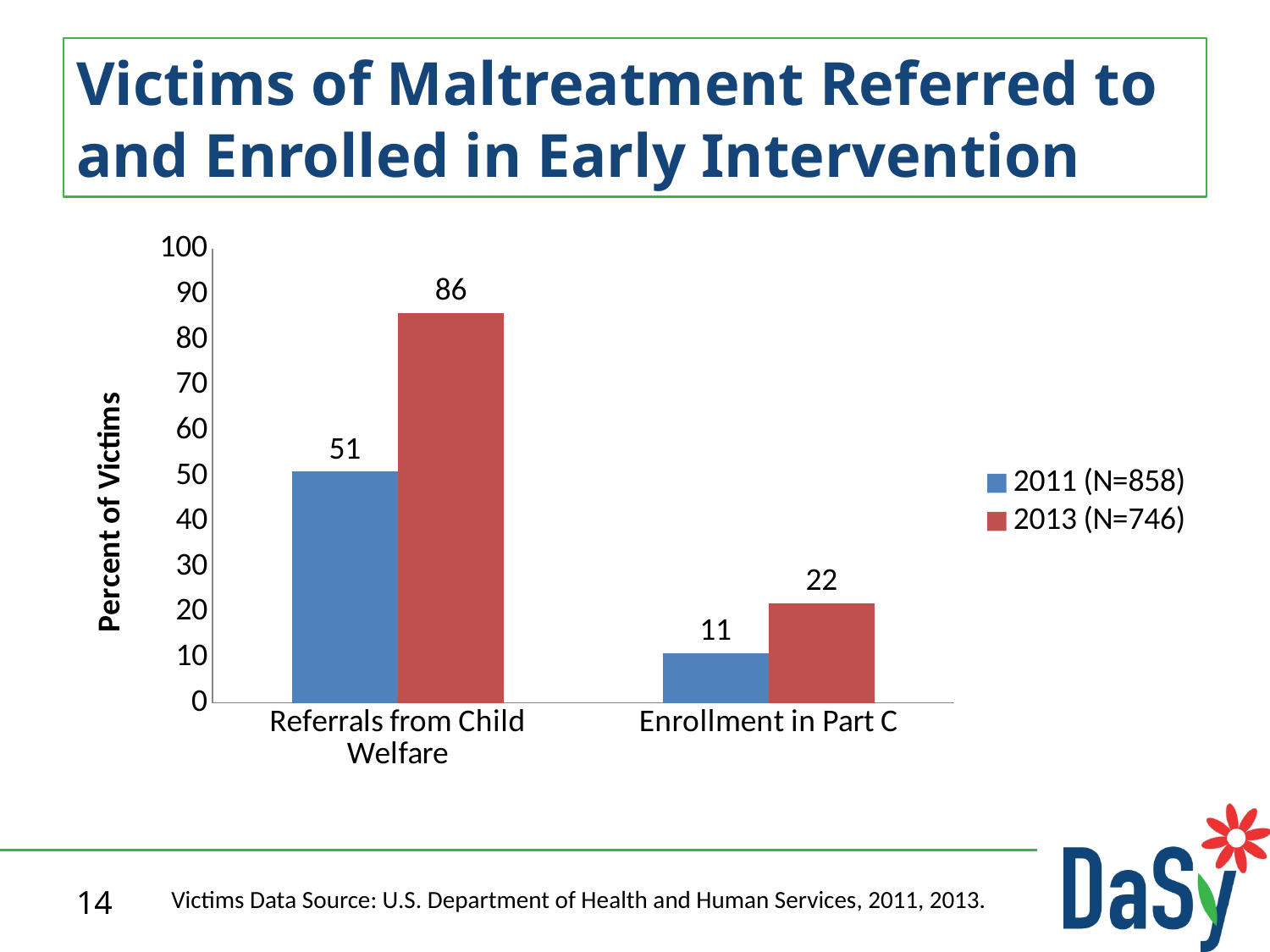
What kind of chart is shown on the slide? Bar chart Which category has the lowest value for the 2011 (N=858) series? Enrollment in Part C What is the value for 2011 (N=858) in the Enrollment in Part C category? 11 What is the difference between the 2013 (N=746) and 2011 (N=858) values for Enrollment in Part C? 11 What is the difference between the 2013 (N=746) and 2011 (N=858) values for Referrals from Child Welfare? 35 How many categories are shown on the x axis? 2 What is the value for 2013 (N=746) in the Referrals from Child Welfare category? 86 Which is larger: the 2011 (N=858) value for Referrals from Child Welfare or the 2013 (N=746) value for Enrollment in Part C? 2011 (N=858) value for Referrals from Child Welfare What is the value for 2013 (N=746) in the Enrollment in Part C category? 22 Which category has the highest value for the 2013 (N=746) series? Referrals from Child Welfare How many series does the legend list? 2 What is the value for 2011 (N=858) in the Referrals from Child Welfare category? 51